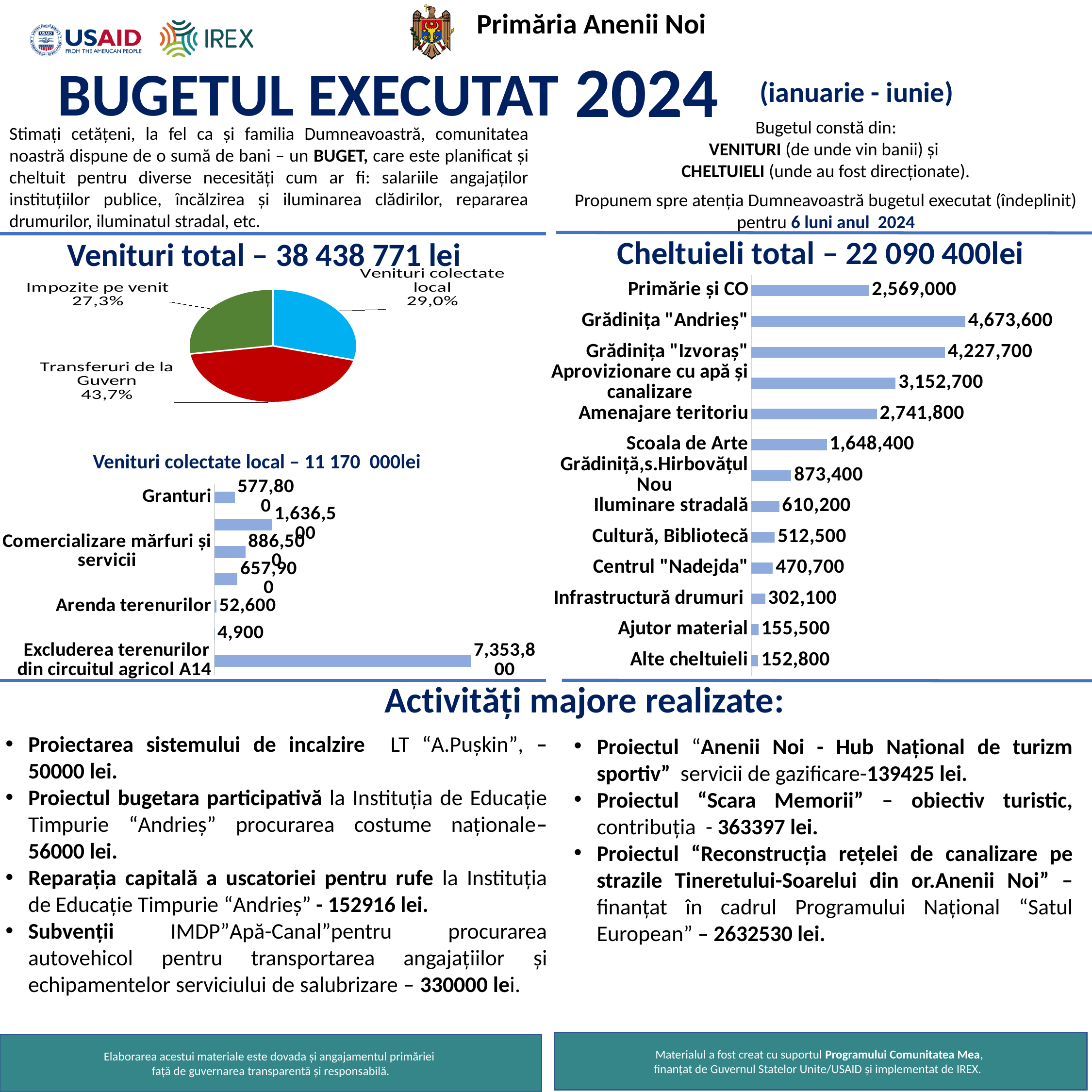
In the 'Cheltuieli total' chart, what is the value for Grădinița "Andrieș"? 4,673,600 How many categories are shown in the 'Cheltuieli total' chart? 13 In the 'Venituri total' pie chart, what share does Transferuri de la Guvern have? 43,7% In the 'Venituri total' pie chart, which slice is the smallest? Impozite pe venit In the 'Venituri colectate local' chart, which is larger: Granturi or Arenda terenurilor? Granturi In the 'Cheltuieli total' chart, which is larger: Iluminare stradală or Cultură, Bibliotecă? Iluminare stradală In the 'Venituri colectate local' chart, what is the value for Excluderea terenurilor din circuitul agricol A14? 7,353,800 What type of chart is used for 'Venituri total'? Pie chart In the 'Cheltuieli total' chart, what is the value for Infrastructură drumuri? 302,100 In the 'Cheltuieli total' chart, what is the difference between Grădinița "Andrieș" and Grădinița "Izvoraș"? 445,900 In the 'Cheltuieli total' chart, which category has the lowest value? Alte cheltuieli In the 'Cheltuieli total' chart, which category has the highest value? Grădinița "Andrieș"